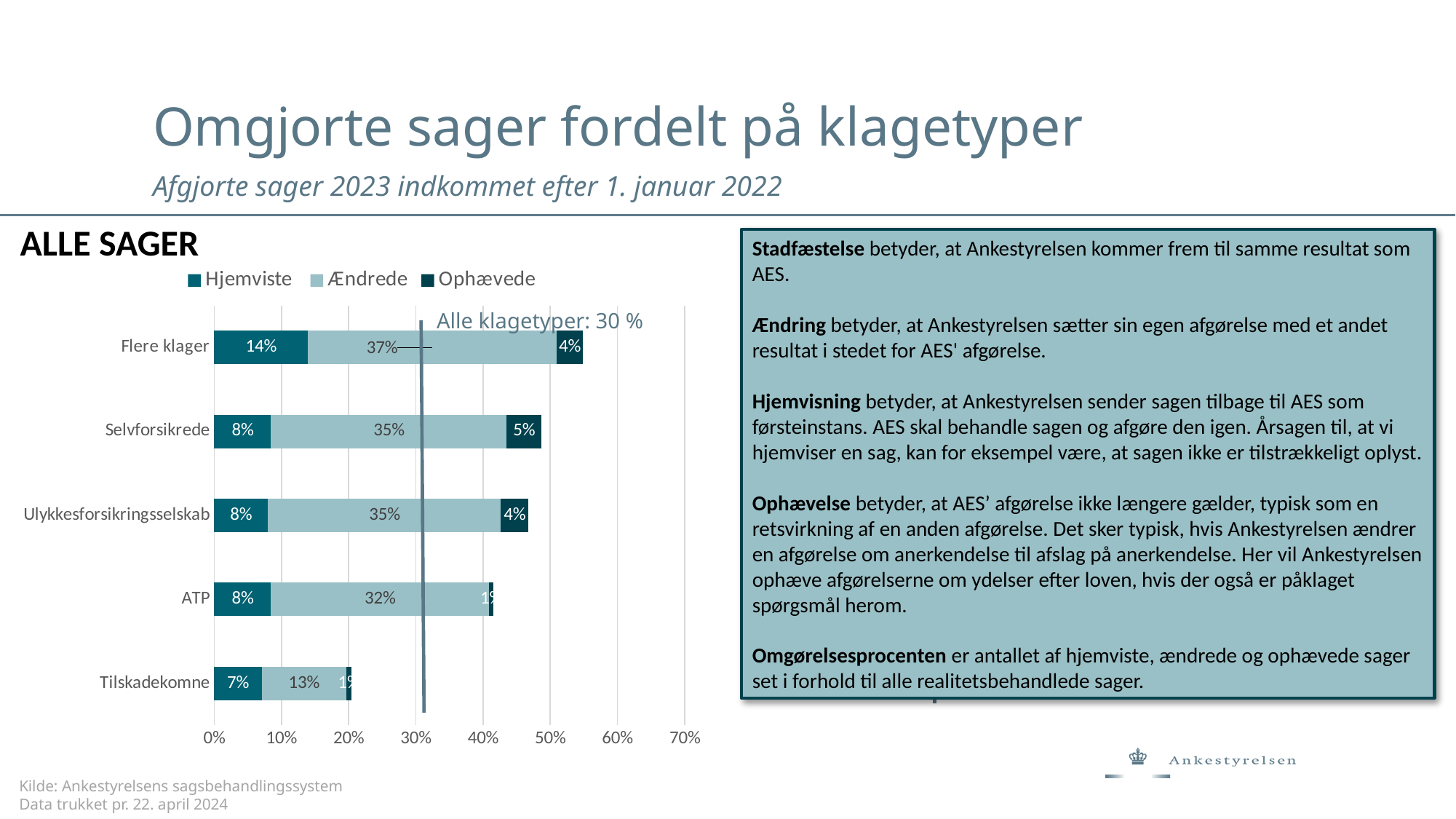
What is the difference between the Ændrede values for Flere klager and Tilskadekomne? 24 percentage points What is the Ændrede value for ATP? 32% What is the Hjemviste value for Flere klager? 14% What is the Ophævede value for Selvforsikrede? 5% What value does the vertical reference line labelled 'Alle klagetyper' mark? 30 % Which category has the lowest Ændrede value? Tilskadekomne Which category has the highest Ændrede value? Flere klager How many series does the chart legend list? 3 Is the Hjemviste value for Flere klager larger or smaller than the Hjemviste value for Tilskadekomne? Larger What is the total of the stacked bar for Selvforsikrede? 48% How many categories are shown on the chart? 5 What kind of chart is shown on the slide? Stacked bar chart